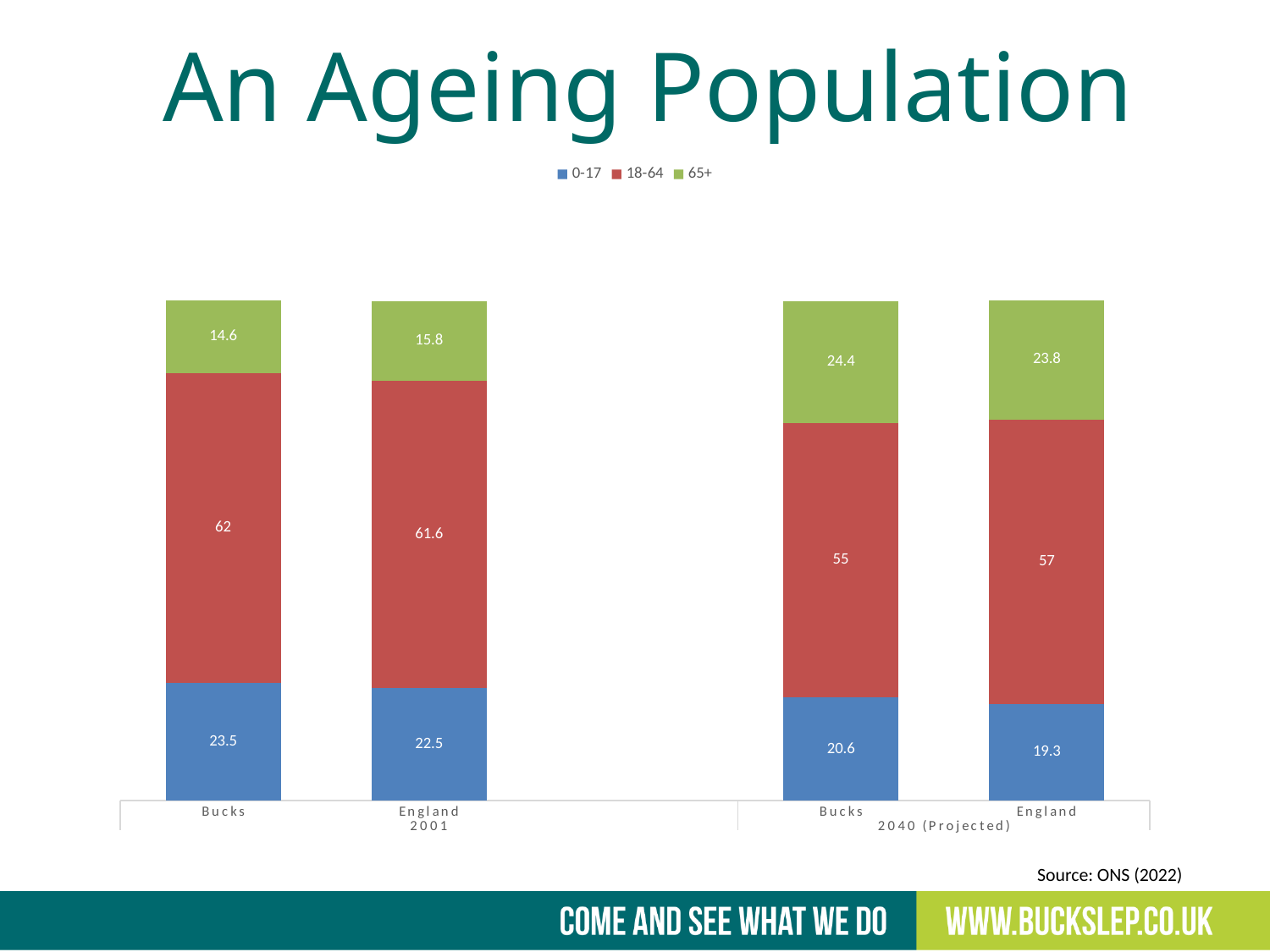
What kind of chart is shown on the slide? Stacked bar chart What is the value for the 65+ series for Bucks in 2001? 14.6 How many series does the legend list? 3 Which bar has the highest value for the 65+ series? Bucks 2040 (Projected) What is the difference between the 65+ value for Bucks in 2040 (Projected) and the 65+ value for Bucks in 2001? 9.8 What is the total of the stacked bar for Bucks in 2040 (Projected)? 100 What is the value for the 65+ series for England in 2001? 15.8 What is the value for the 18-64 series for England in 2040 (Projected)? 57 Which bar has the lowest value for the 0-17 series? England 2040 (Projected) How many stacked bars are plotted in the chart? 4 What is the value for the 0-17 series for Bucks in 2040 (Projected)? 20.6 Which is larger: the 18-64 value for Bucks in 2001 or the 18-64 value for England in 2001? Bucks in 2001